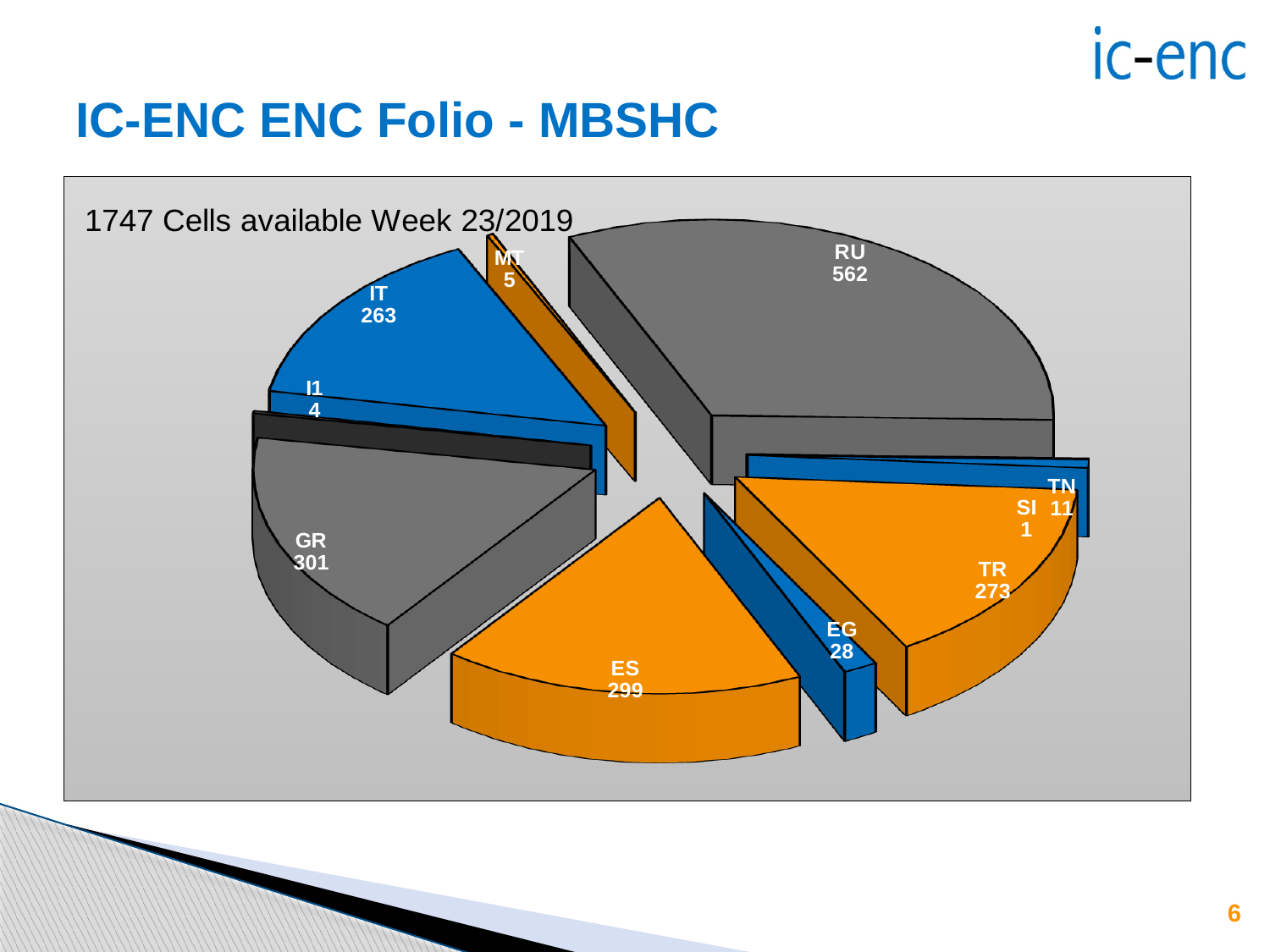
How many slices does the pie chart have? 10 Which slice of the pie chart has the lowest value? SI Which slice of the pie chart has the highest value? RU What is the value for EG in the pie chart? 28 What is the value for ES in the pie chart? 299 What is the difference between the values for RU and GR? 261 Which week does the chart heading say the cells are available for? Week 23/2019 What is the value for GR in the pie chart? 301 What type of chart is shown on the slide? pie chart Which has a larger value, IT or TR? TR How many cells are shown for RU in the pie chart? 562 What is the total number of cells stated in the chart's heading? 1747